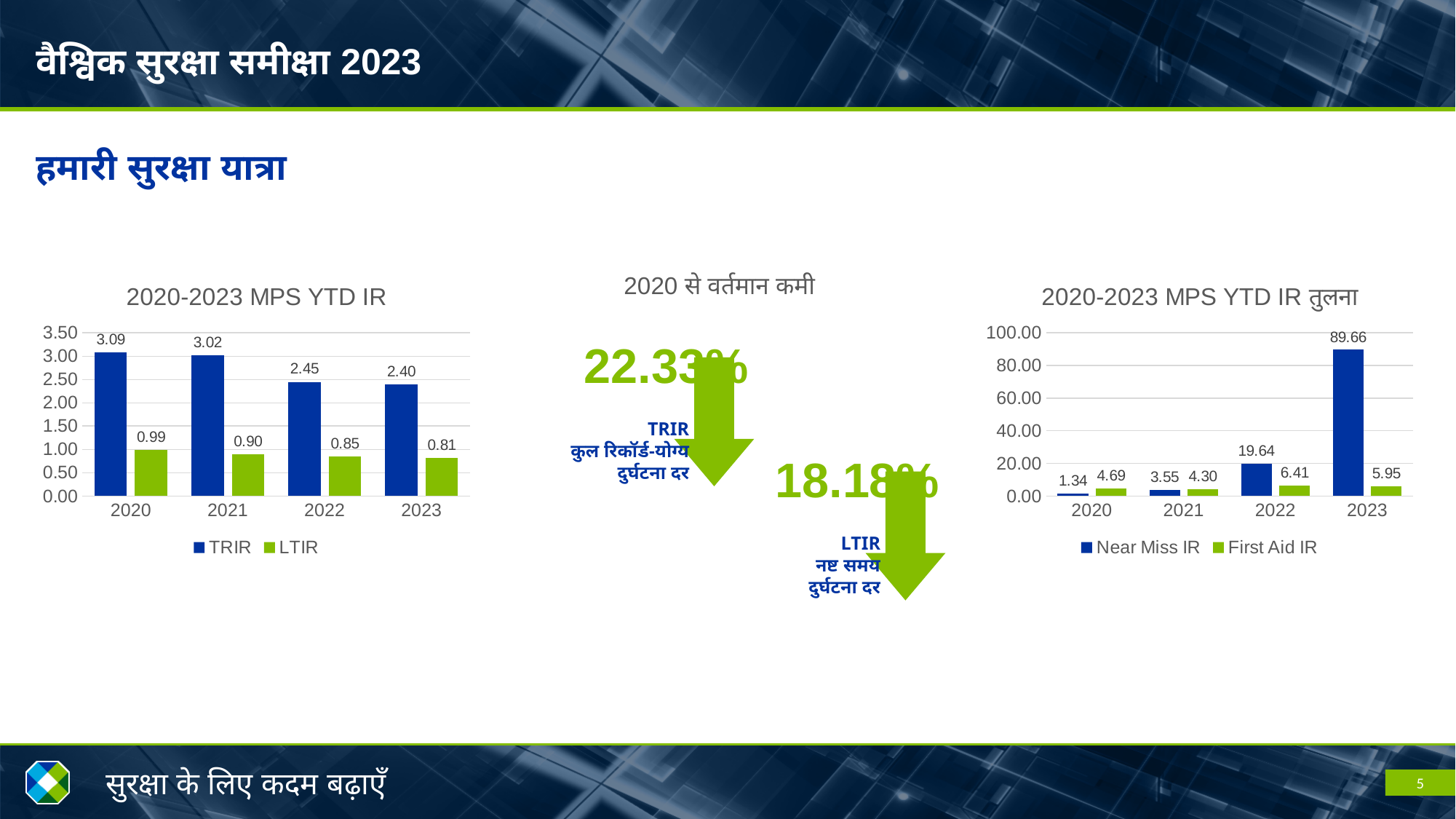
In the chart titled "2020-2023 MPS YTD IR", what is the TRIR value for 2020? 3.09 In the chart titled "2020-2023 MPS YTD IR", what is the LTIR value for 2023? 0.81 In the chart titled "2020-2023 MPS YTD IR तुलना", which year has the highest Near Miss IR value? 2023 In the chart titled "2020-2023 MPS YTD IR", which year has the lowest TRIR value? 2023 In the chart titled "2020-2023 MPS YTD IR", what is the difference between the TRIR values for 2020 and 2023? 0.69 What kind of chart is the one titled "2020-2023 MPS YTD IR तुलना"? bar chart In the chart titled "2020-2023 MPS YTD IR तुलना", how many years are shown on the x axis? 4 In the chart titled "2020-2023 MPS YTD IR", does the TRIR value rise or fall from 2020 to 2023? fall In the chart titled "2020-2023 MPS YTD IR तुलना", which is larger in 2020, Near Miss IR or First Aid IR? First Aid IR In the chart titled "2020-2023 MPS YTD IR तुलना", what is the Near Miss IR value for 2023? 89.66 In the chart titled "2020-2023 MPS YTD IR", how many series does the legend list? 2 In the chart titled "2020-2023 MPS YTD IR तुलना", what is the First Aid IR value for 2022? 6.41